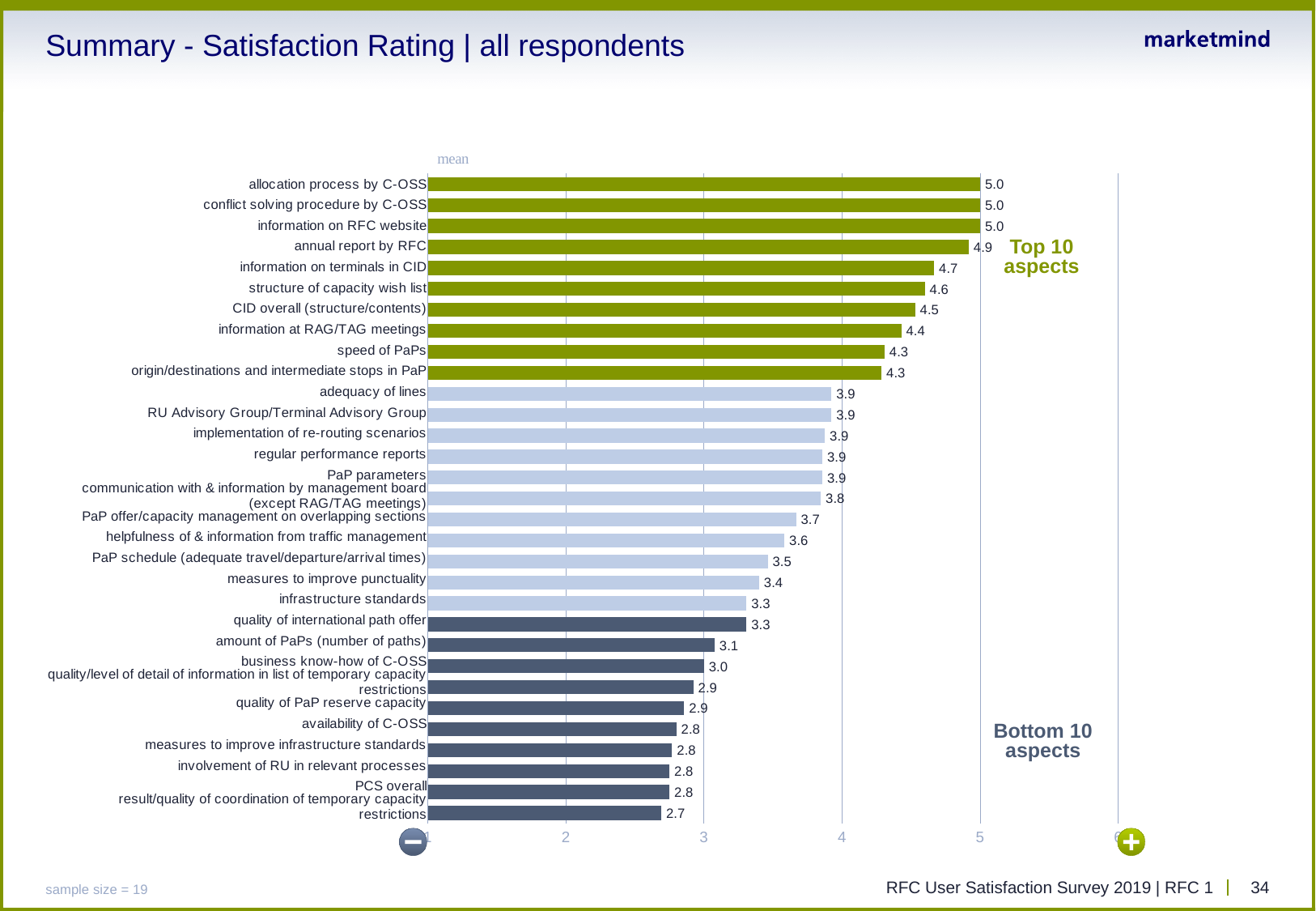
What is the mean satisfaction rating for 'measures to improve punctuality'? 3.4 Is the mean rating for 'CID overall (structure/contents)' greater or less than 4? greater What is the highest mean satisfaction rating shown on the chart? 5.0 What is the mean satisfaction rating for 'speed of PaPs'? 4.3 What is the mean satisfaction rating for 'annual report by RFC'? 4.9 Which aspect has the lowest mean satisfaction rating? result/quality of coordination of temporary capacity restrictions What is the difference between the mean rating for 'information on terminals in CID' and 'amount of PaPs (number of paths)'? 1.6 Which has a higher mean rating: 'structure of capacity wish list' or 'helpfulness of & information from traffic management'? structure of capacity wish list What is the sample size stated on the slide? 19 What type of chart is shown on the slide? bar chart How many aspects are plotted on the chart? 31 What is the mean satisfaction rating for 'PCS overall'? 2.8